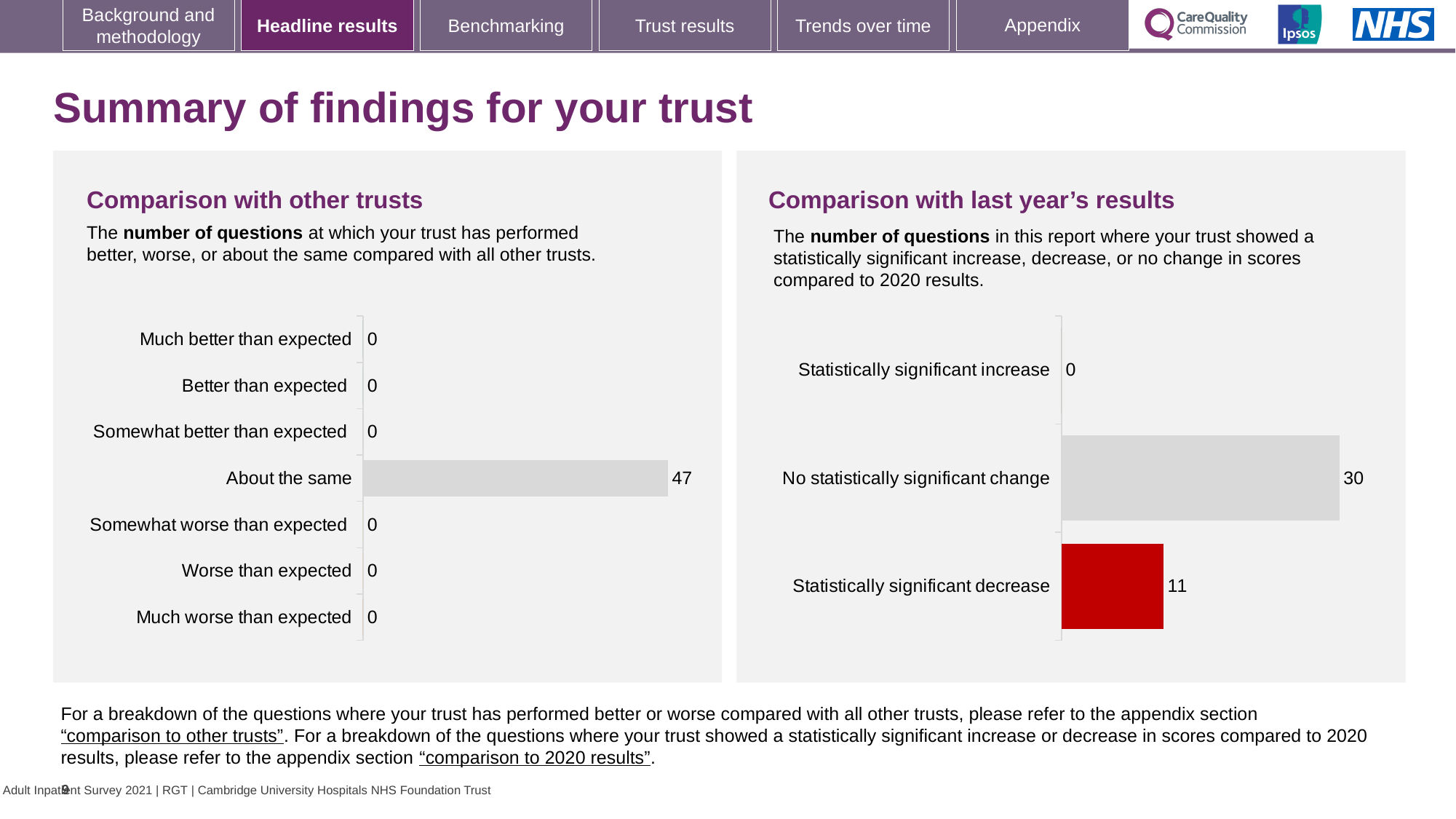
In the 'Comparison with last year's results' chart, what is the value for 'Statistically significant increase'? 0 What kind of chart is the 'Comparison with other trusts' chart? Bar chart How many categories are shown in the 'Comparison with other trusts' chart? 7 In the 'Comparison with last year's results' chart, which bar is coloured red? Statistically significant decrease How many categories are shown in the 'Comparison with last year's results' chart? 3 In the 'Comparison with other trusts' chart, which category has the highest value? About the same In the 'Comparison with other trusts' chart, what is the value for 'Somewhat worse than expected'? 0 In the 'Comparison with other trusts' chart, what is the value for 'About the same'? 47 In the 'Comparison with last year's results' chart, what is the value for 'Statistically significant decrease'? 11 In the 'Comparison with last year's results' chart, what is the value for 'No statistically significant change'? 30 In the 'Comparison with last year's results' chart, which is larger: 'No statistically significant change' or 'Statistically significant decrease'? No statistically significant change In the 'Comparison with last year's results' chart, what is the difference between 'No statistically significant change' and 'Statistically significant decrease'? 19